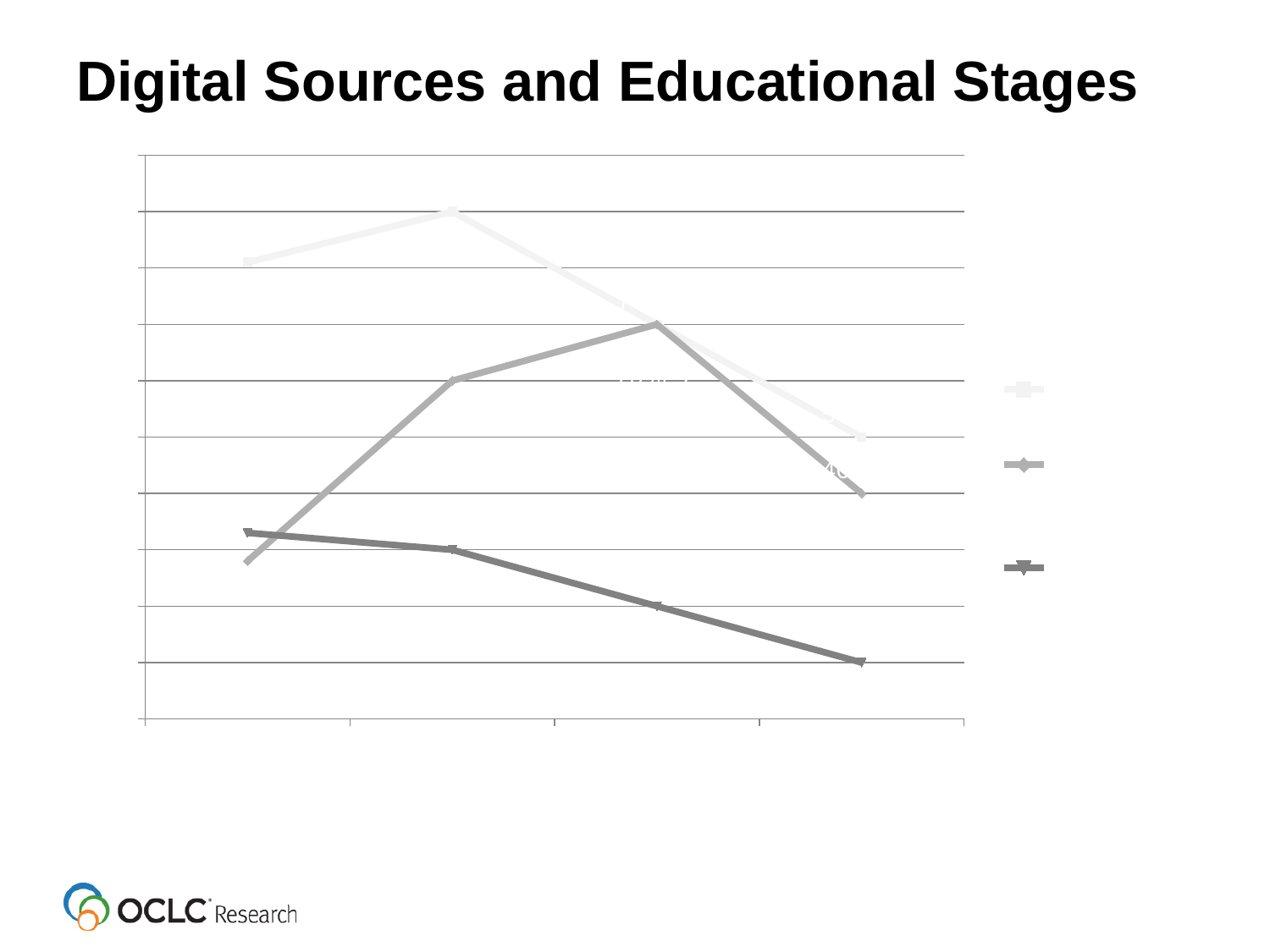
Does the medium grey line rise or fall between its third and fourth points? fall What is the title of the slide containing the chart? Digital Sources and Educational Stages Does the darkest grey line rise or fall from left to right along the x axis? fall How many series does the legend list? 3 Does the lightest line rise or fall between its first and second points? rise Which line reaches the highest point on the chart: the lightest, the medium grey, or the darkest? the lightest Which line has the lowest point on the chart: the lightest, the medium grey, or the darkest? the darkest How many data points does each line have? 4 What kind of chart is shown on the slide? line chart